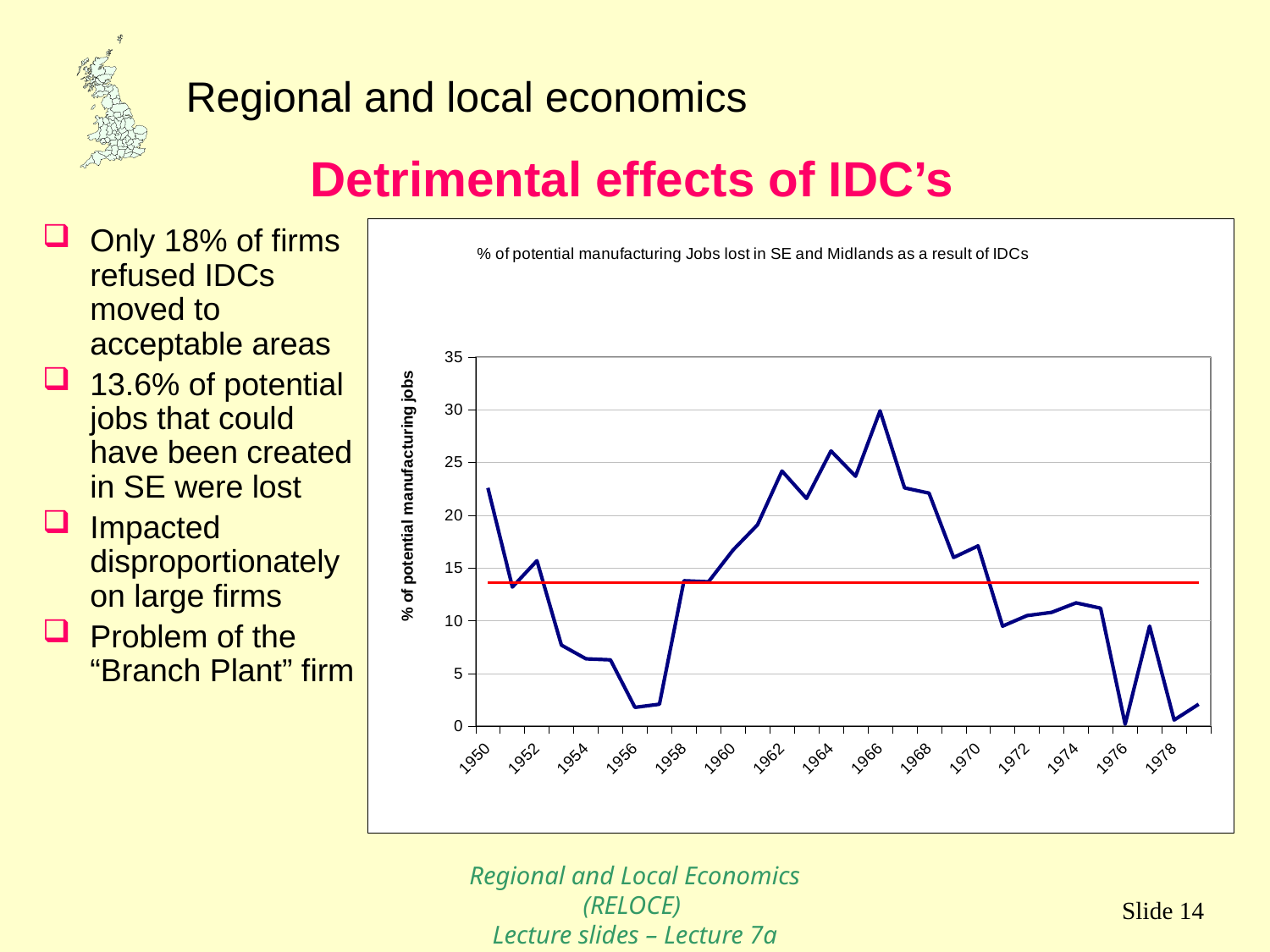
Which year has the larger value, 1956 or 1958? 1958 In which year does the line reach its highest value? 1966 Which year has the larger value, 1950 or 1952? 1950 Is the value for 1972 greater or less than 15? less In which year does the line reach its lowest value? 1976 Is the value for 1950 greater or less than 20? greater What is the label on the vertical axis of the chart? % of potential manufacturing jobs What is the title of the chart? % of potential manufacturing Jobs lost in SE and Midlands as a result of IDCs Is the value for 1956 greater or less than 5? less What kind of chart is shown on the slide? line chart Between 1958 and 1966, does the line generally rise or fall? rise